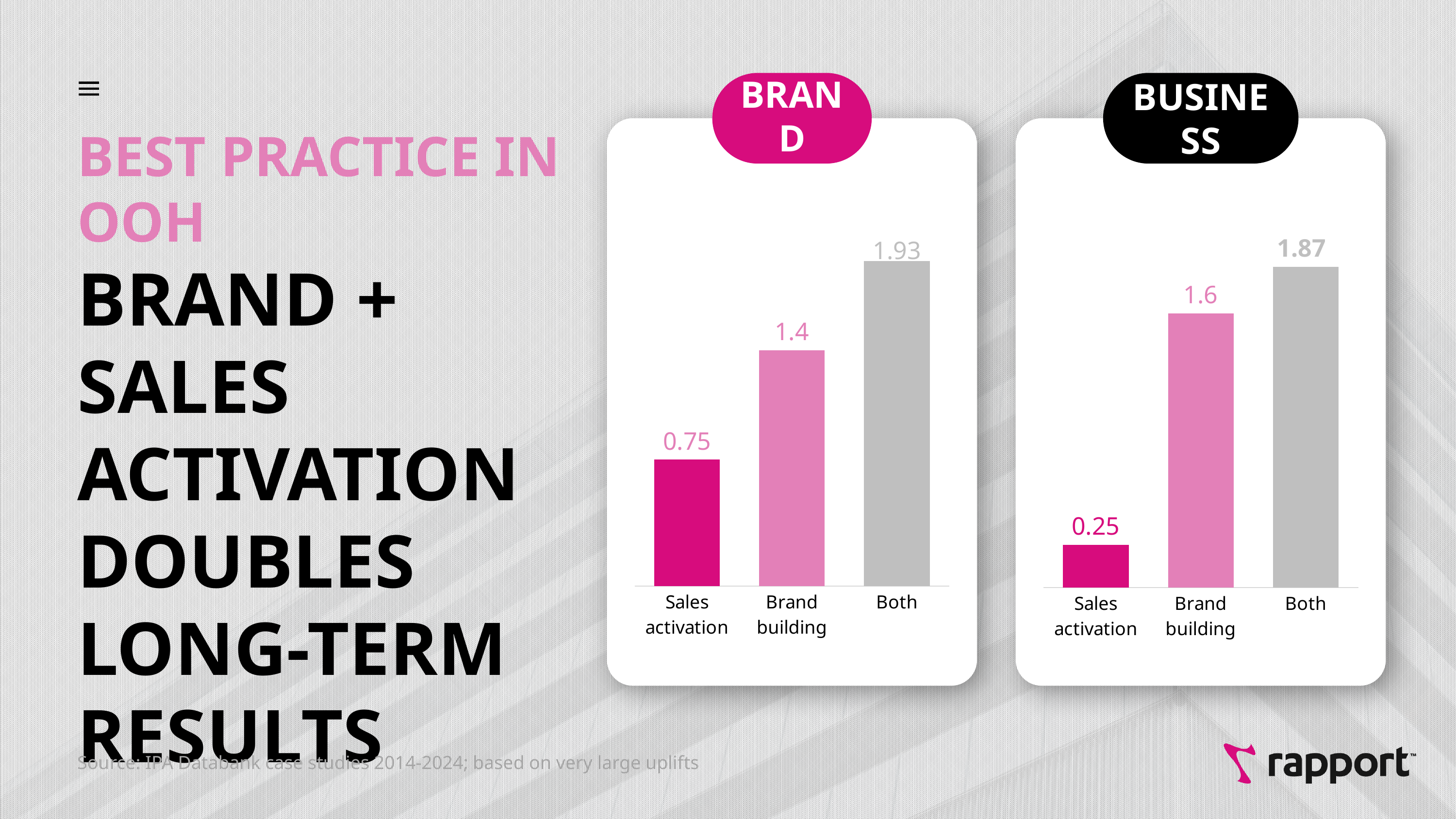
In the BUSINESS chart, what is the value for Brand building? 1.6 In the BRAND chart, what is the value for Both? 1.93 In the BRAND chart, what is the value for Sales activation? 0.75 How many categories are shown in the BUSINESS chart? 3 Which is larger: the value for Both in the BRAND chart or the value for Both in the BUSINESS chart? Both in the BRAND chart What type of chart is the BRAND chart? Bar chart In the BRAND chart, which category has the highest value? Both In the BUSINESS chart, what is the difference between the values for Brand building and Sales activation? 1.35 In the BRAND chart, do the values rise or fall from Sales activation to Both? Rise In the BRAND chart, what is the difference between the values for Both and Brand building? 0.53 In the BUSINESS chart, which category has the lowest value? Sales activation In the BUSINESS chart, what is the value for Sales activation? 0.25